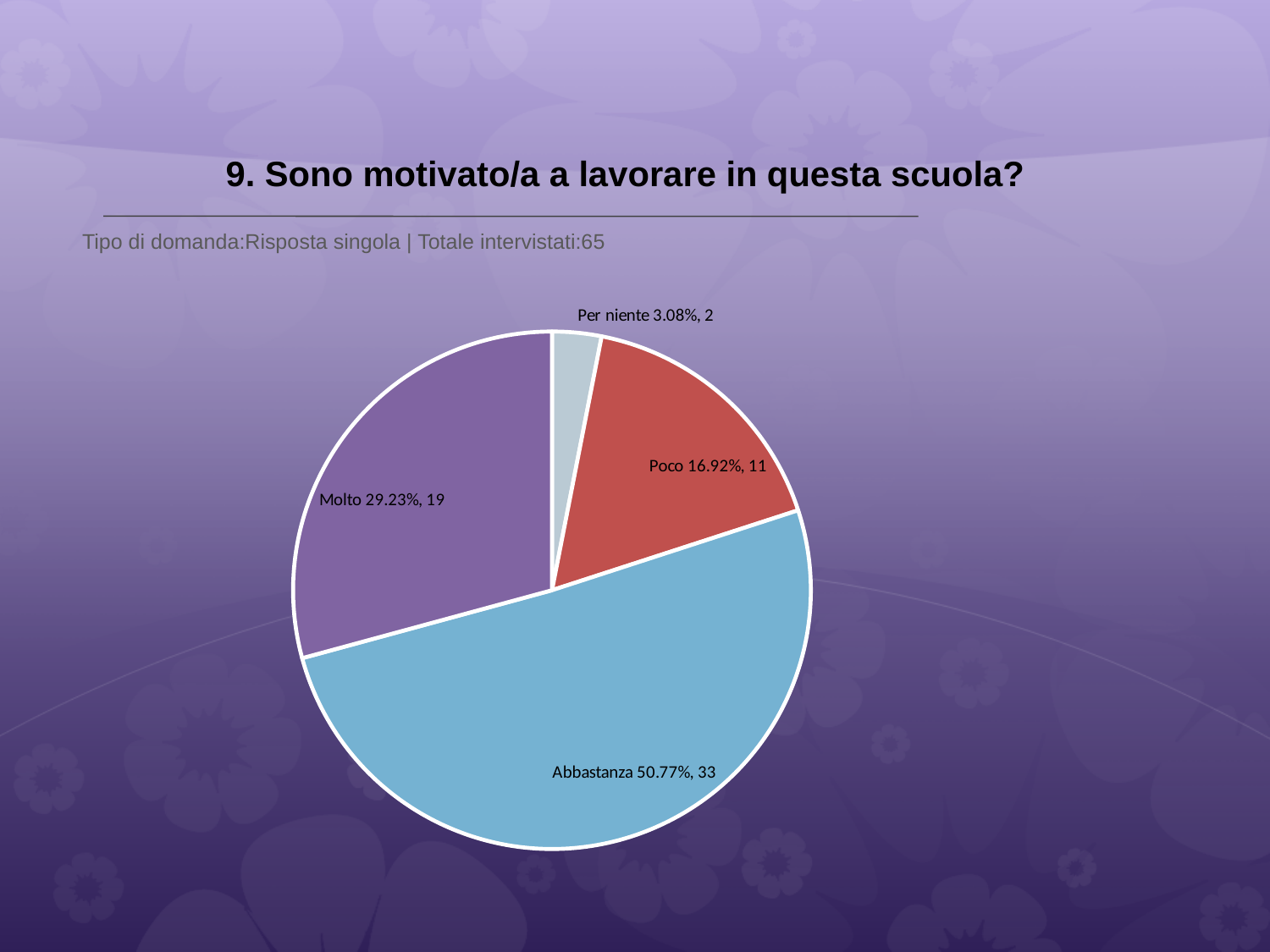
How many slices does the pie chart have? 4 Which has more respondents, 'Poco' or 'Molto'? Molto What is the total number of respondents across all slices? 65 How many respondents answered 'Molto'? 19 What percentage share does the 'Per niente' slice have? 3.08% Which category has the smallest slice? Per niente What is the difference in respondent count between 'Abbastanza' and 'Molto'? 14 Which category has the largest slice? Abbastanza What is the title of the chart on the slide? 9. Sono motivato/a a lavorare in questa scuola? What kind of chart is shown on the slide? pie chart How many respondents answered 'Poco'? 11 What percentage share does the 'Abbastanza' slice have? 50.77%